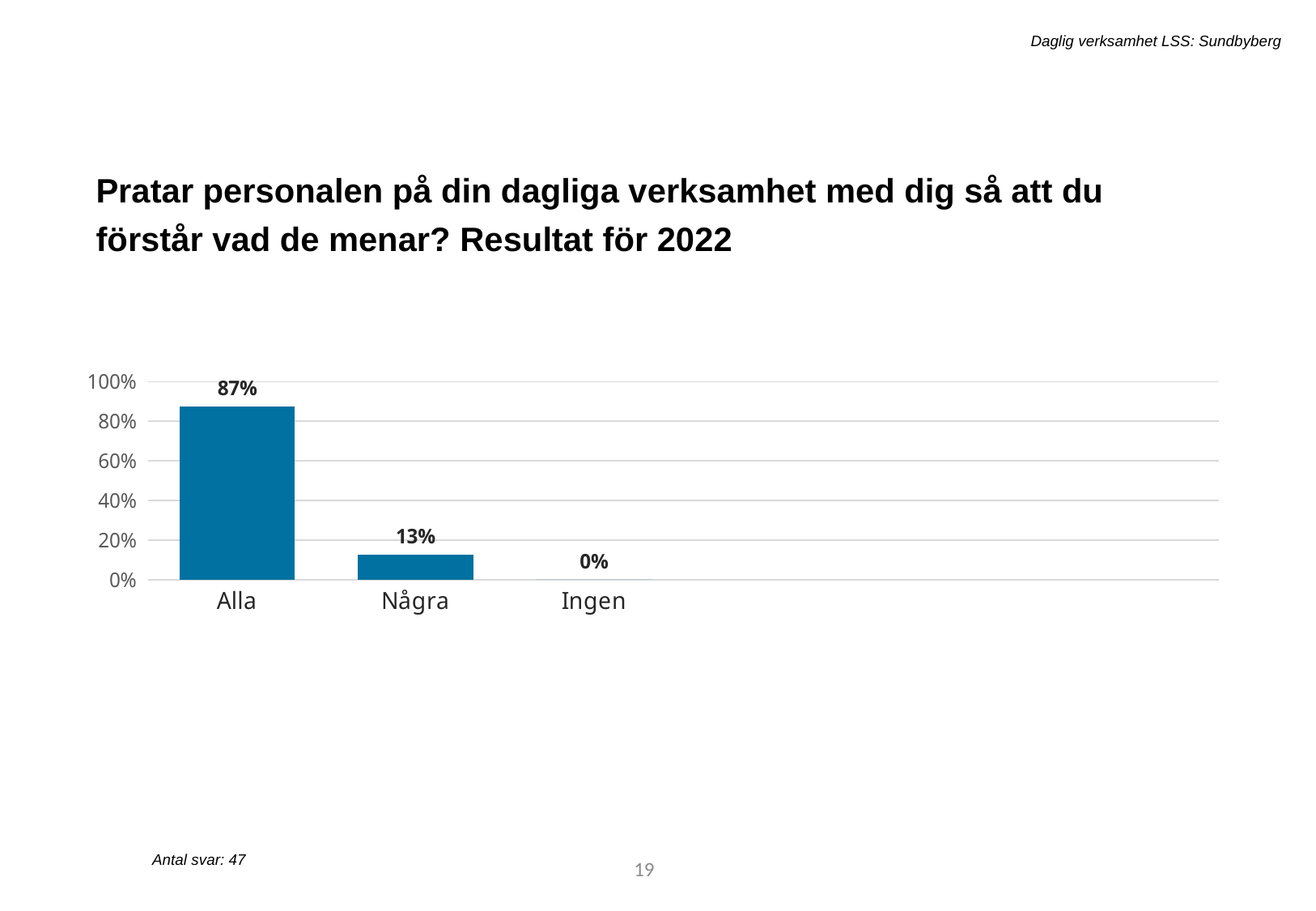
Which category has the highest value? Alla What is the value for Alla? 87% What is the value for Ingen? 0% Which category has the lowest value? Ingen Is the value for Alla greater or less than 80%? greater What is the value for Några? 13% What kind of chart is shown on the slide? bar chart How many categories are shown on the x axis? 3 What is the difference between the values for Alla and Några? 74% Which is larger, the value for Några or the value for Ingen? Några Do the values rise or fall from left to right along the x axis? fall Is the value for Några greater or less than 20%? less